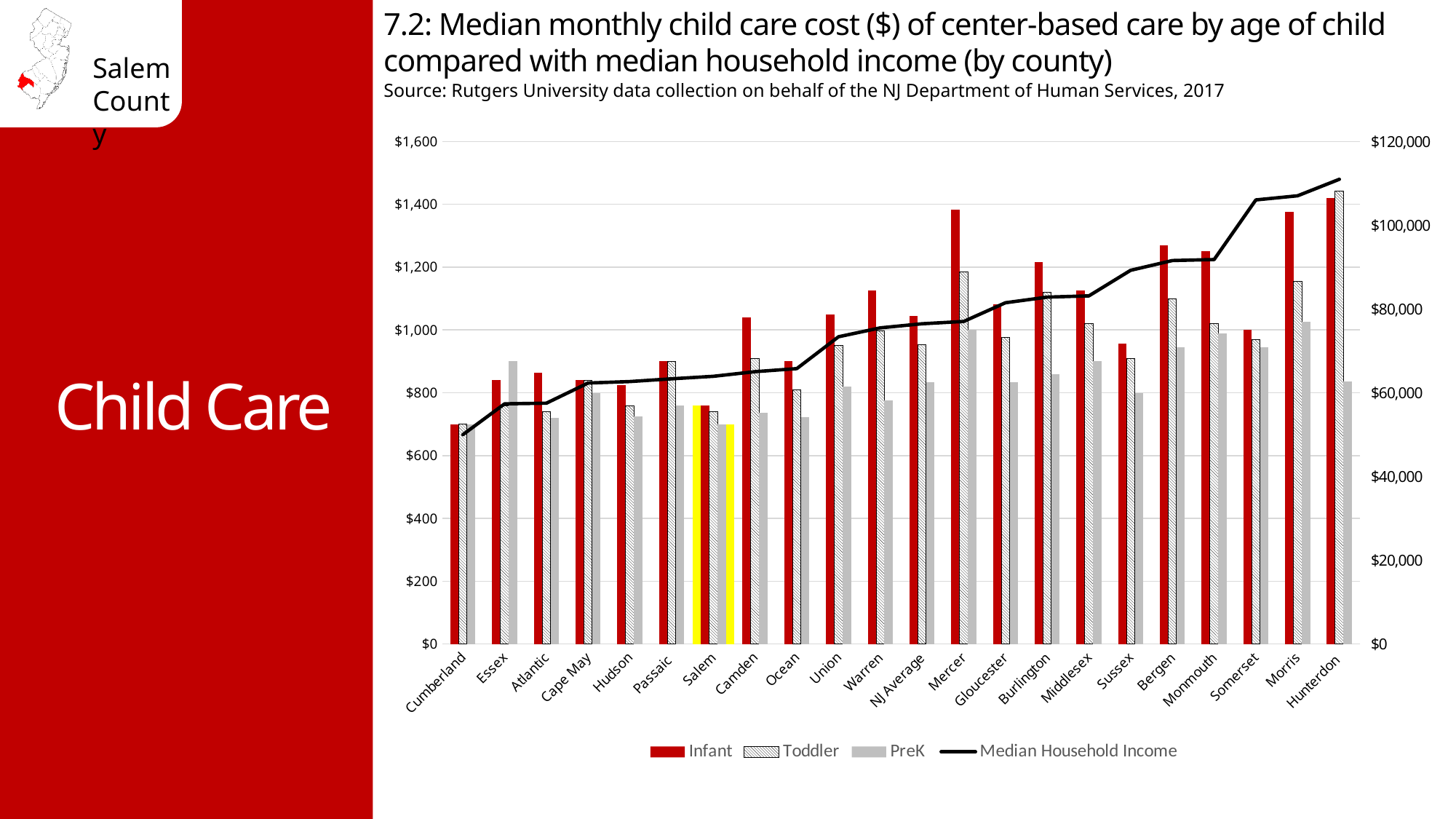
Which is larger, the Infant cost for Mercer or the Infant cost for Salem? Mercer Which category has the lowest Infant cost? Cumberland How many counties/categories are shown along the x axis of the chart? 22 Is the Infant cost for Mercer greater or less than $1,200? greater Is the Infant cost for Salem greater or less than $800? less How many series does the chart's legend list? 4 Is the Median Household Income for Cumberland greater or less than $60,000? less What kind of chart is used to show the child care costs by age of child? Bar chart (with a line for Median Household Income) Which series in the legend is drawn as a line rather than bars? Median Household Income Does the Median Household Income line generally rise or fall from left to right across the counties? rise Which category has the highest Toddler cost? Hunterdon